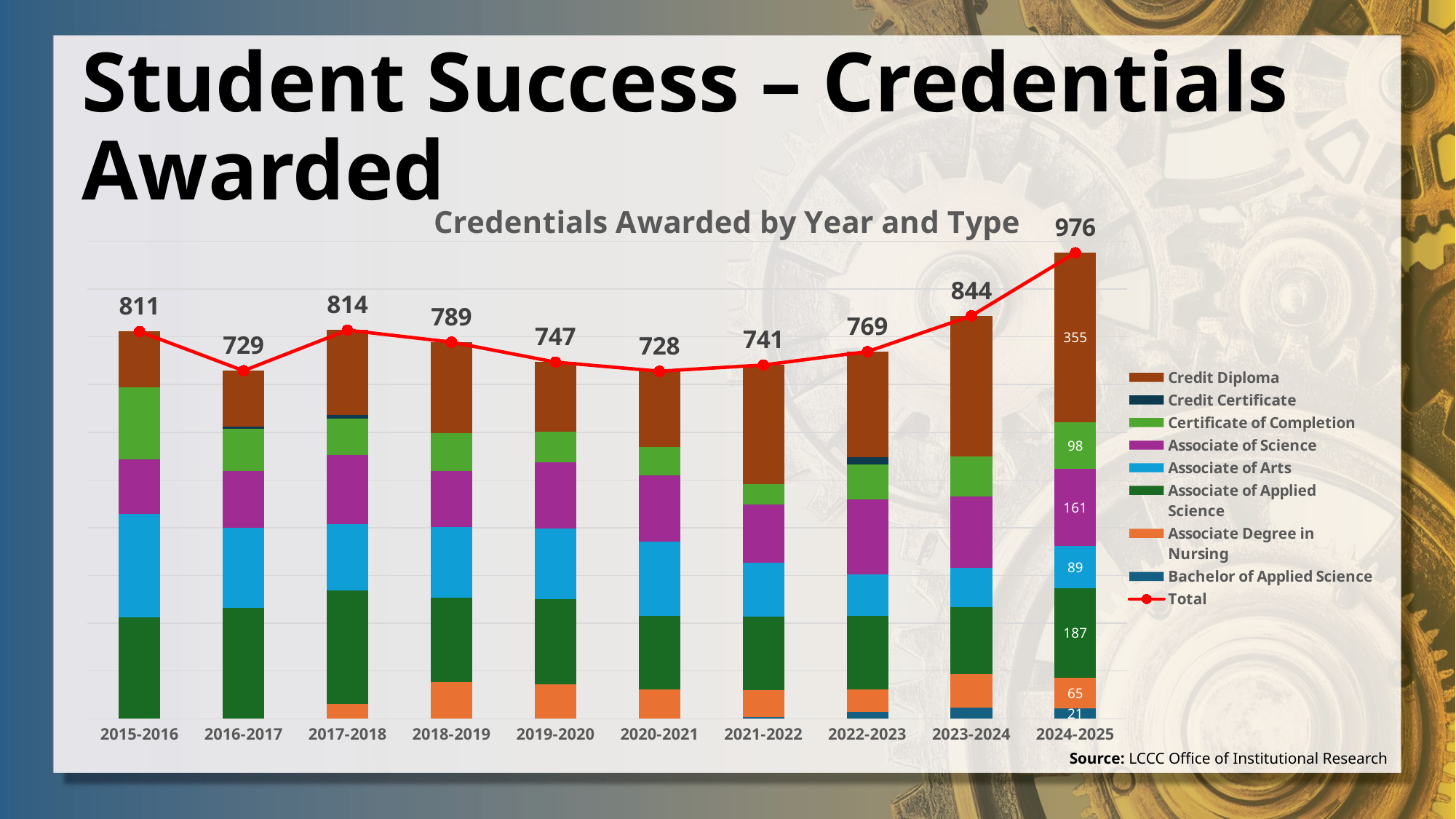
How many academic years are shown on the x axis? 10 What is the difference between the total credentials awarded in 2024-2025 and in 2023-2024? 132 What is the title of the chart? Credentials Awarded by Year and Type How many entries does the legend list? 9 How many Associate of Applied Science credentials were awarded in 2024-2025? 187 How many Credit Diplomas were awarded in 2024-2025? 355 What is the total number of credentials awarded in 2024-2025? 976 Which year has the lowest total of credentials awarded? 2020-2021 What is the total number of credentials awarded in 2016-2017? 729 Which year had more total credentials awarded, 2015-2016 or 2017-2018? 2017-2018 Which year has the highest total of credentials awarded? 2024-2025 What kind of chart is shown on the slide? Stacked bar chart with a line for the total